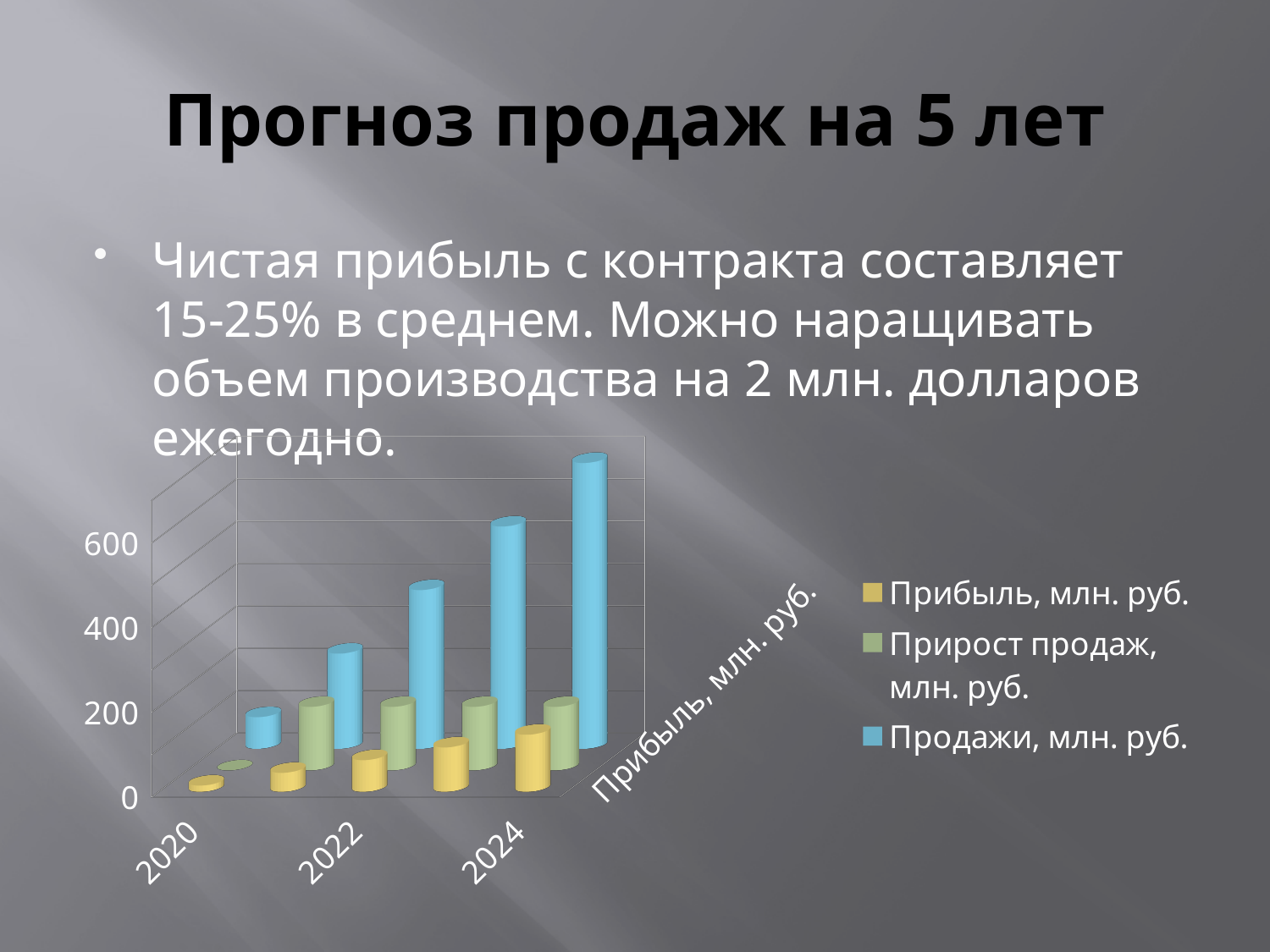
How many series does the chart legend list? 3 Which series is shown in blue in the chart legend? Продажи, млн. руб. Is the value for Прибыль, млн. руб. in 2024 greater or less than 200? less What kind of chart is shown on the slide? bar chart In which year is the value for Продажи, млн. руб. lowest? 2020 Is the value for Продажи, млн. руб. in 2024 greater or less than 600? greater In which year is the value for Продажи, млн. руб. highest? 2024 How many groups of bars (years) are plotted on the chart? 5 Do the values for Продажи, млн. руб. rise or fall from 2020 to 2024? rise Which series is shown in yellow in the chart legend? Прибыль, млн. руб. Do the values for Прибыль, млн. руб. rise or fall from 2020 to 2024? rise In which year is the value for Прибыль, млн. руб. lowest? 2020